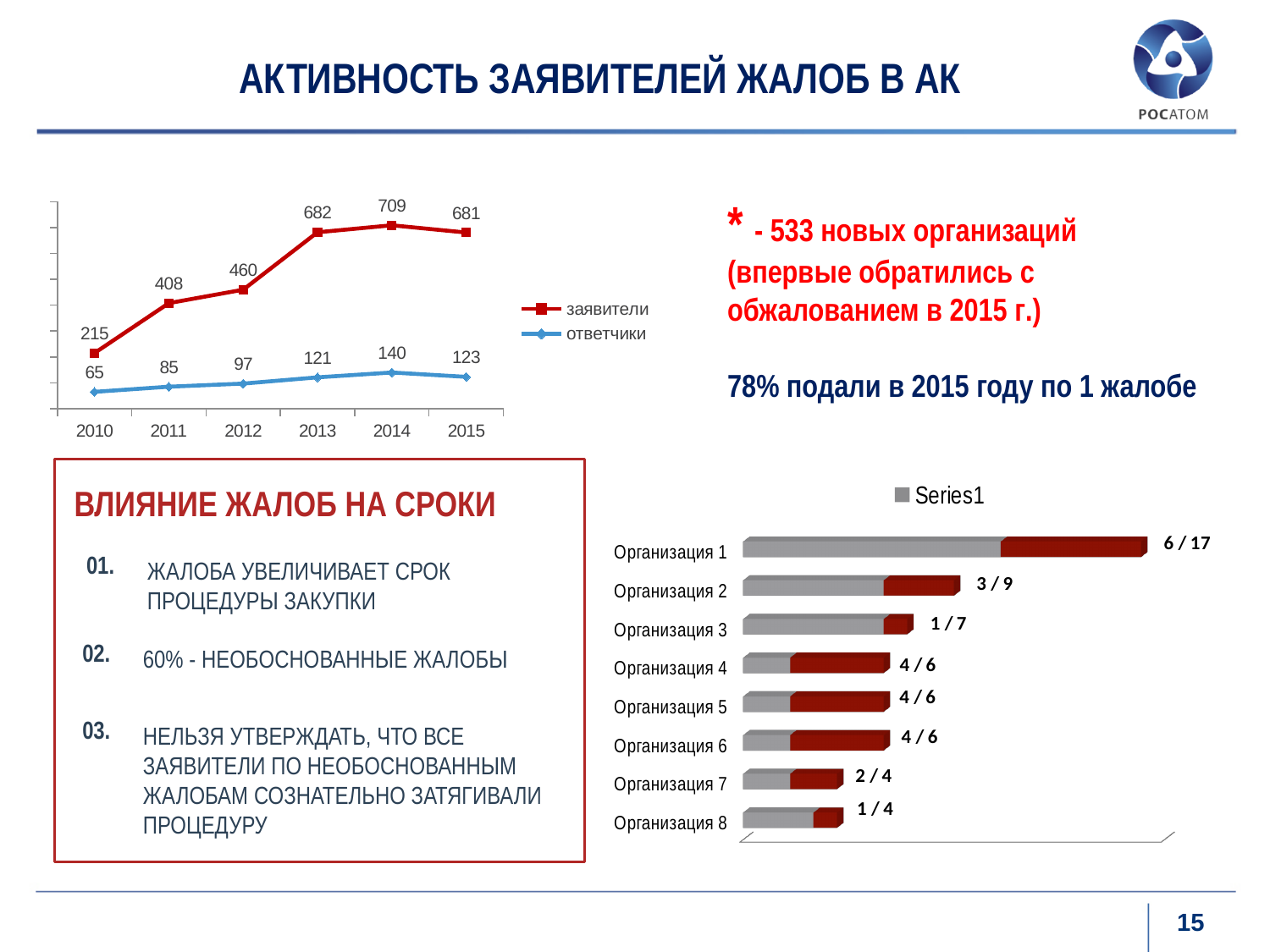
In the line chart at the top left, in which year is the ответчики series lowest? 2010 In the line chart at the top left, what is the value for заявители in 2014? 709 What kind of chart is the chart at the top left of the slide? line chart In the line chart at the top left, what is the difference between заявители and ответчики in 2015? 558 In the line chart at the top left, does the ответчики series rise or fall from 2010 to 2014? rise In the line chart at the top left, which year has the larger value for заявители, 2013 or 2014? 2014 In the line chart at the top left, how many years are shown on the x axis? 6 In the bar chart at the bottom right, how many organizations are listed? 8 In the line chart at the top left, in which year is the заявители series highest? 2014 In the line chart at the top left, what is the value for ответчики in 2012? 97 In the line chart at the top left, how many series does the legend list? 2 In the bar chart at the bottom right, what label is shown for Организация 1? 6 / 17